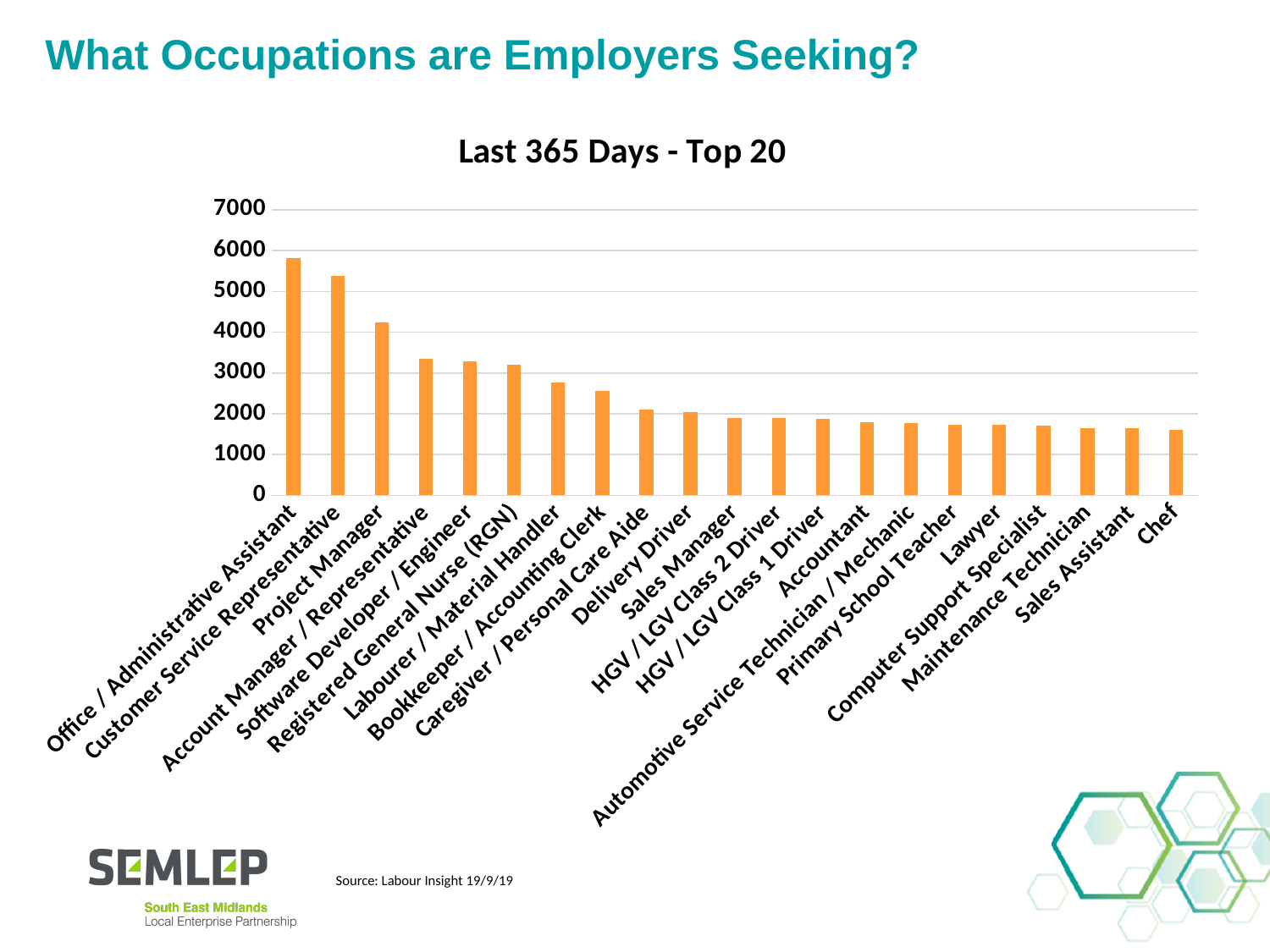
Is the value for Office / Administrative Assistant greater or less than 5000? greater Which occupation has the highest value in the chart? Office / Administrative Assistant Is the value for Project Manager greater or less than 5000? less What kind of chart is shown on the slide? bar chart Which is larger, the value for Project Manager or the value for Account Manager / Representative? Project Manager Which occupation has the lowest value in the chart? Chef Is the value for Bookkeeper / Accounting Clerk greater or less than 2000? greater What is the title of the chart? Last 365 Days - Top 20 Do the values rise or fall moving from left to right along the x axis? fall